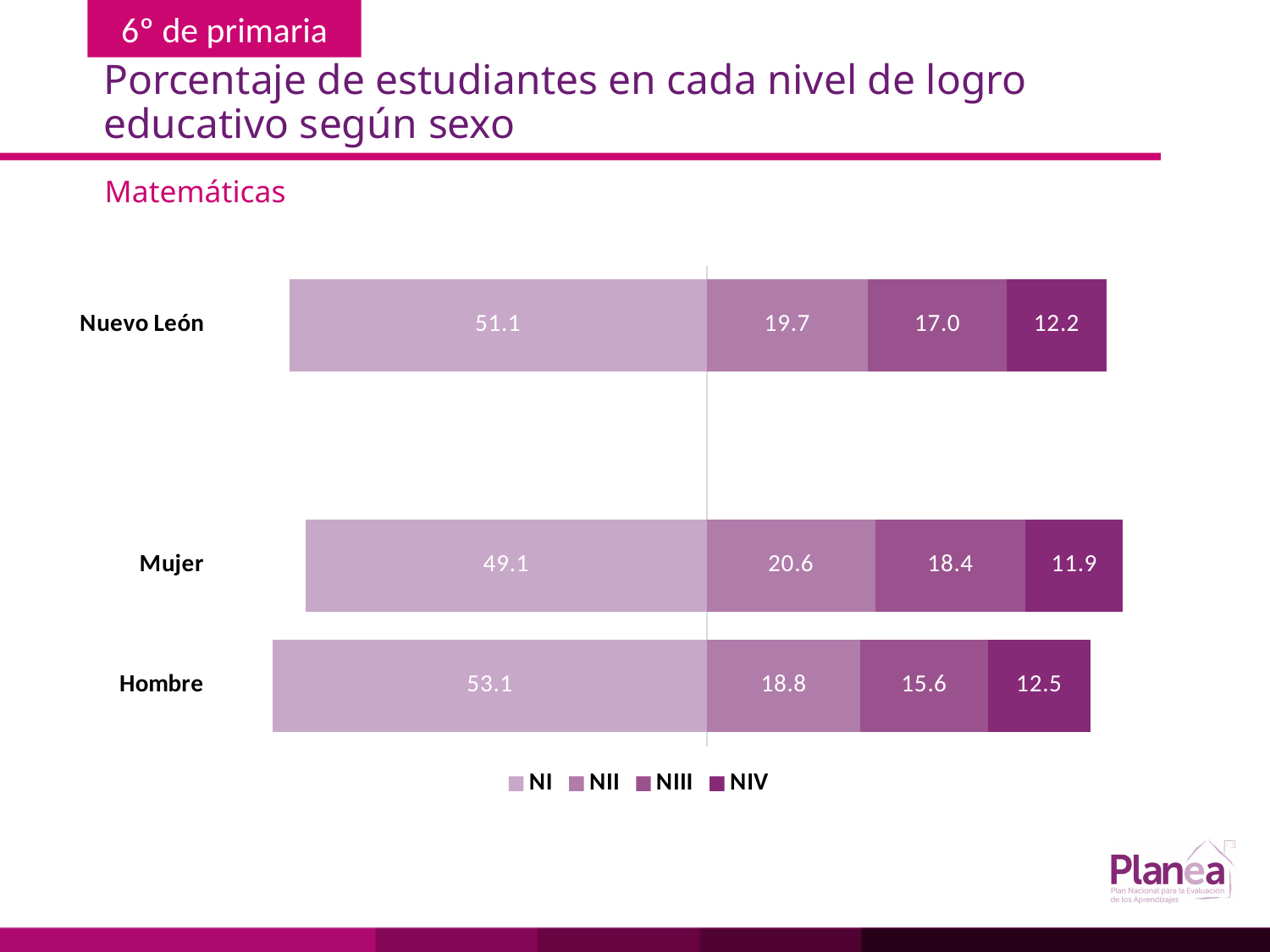
What is the total of the stacked bar for Mujer? 100.0 Which is larger, the NII value for Mujer or the NII value for Nuevo León? Mujer Which category has the lowest NIII value? Hombre How many series does the legend list? 4 What is the NIII value for Mujer? 18.4 What is the NIV value for Hombre? 12.5 What kind of chart is shown? stacked bar chart What is the NI value for Nuevo León? 51.1 What is the NII value for Hombre? 18.8 How many categories are shown on the chart? 3 Which category has the highest NI value? Hombre What is the difference between the NI values for Hombre and Mujer? 4.0